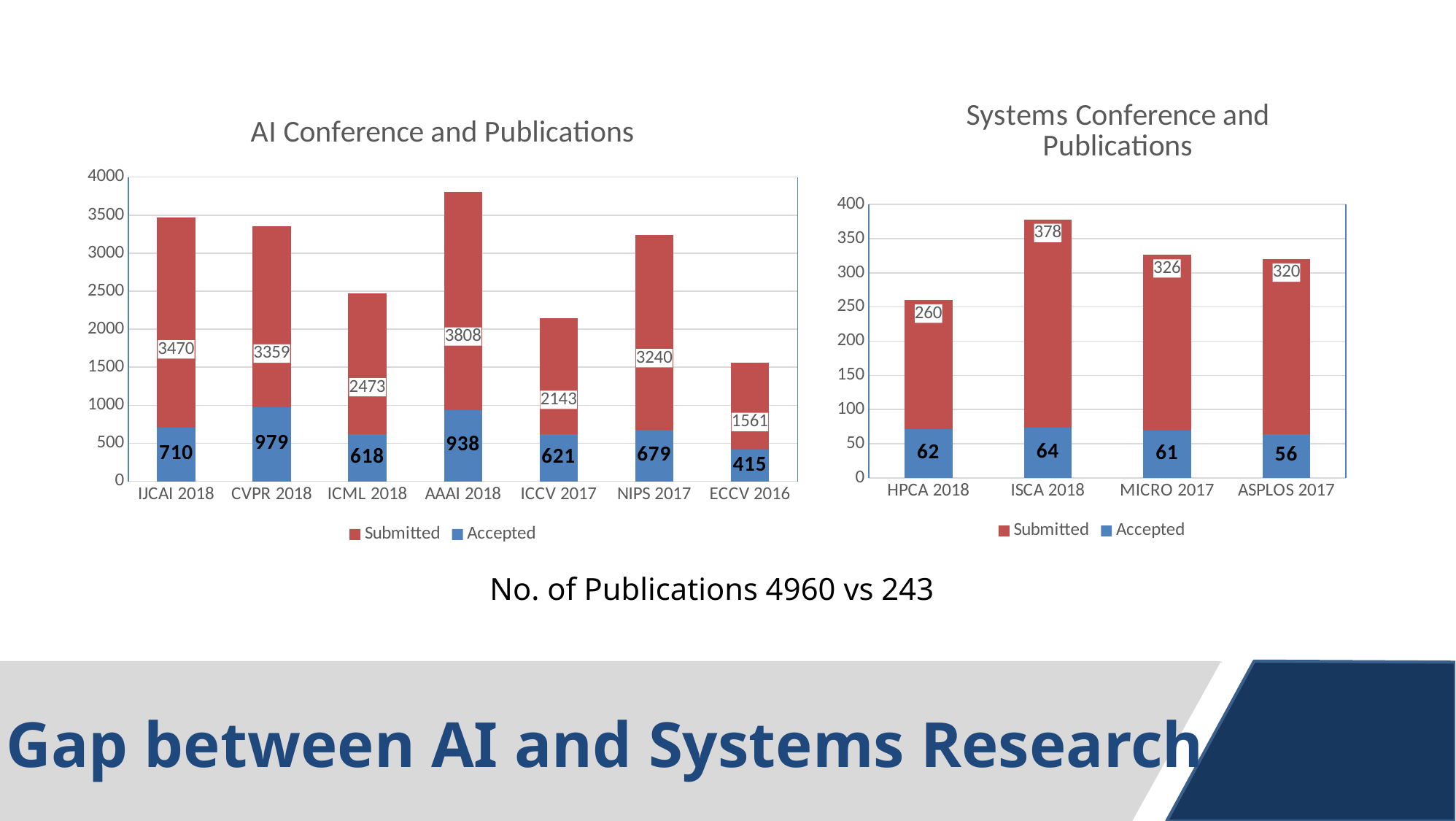
In the Systems Conference and Publications chart, which conference has the highest Submitted value? ISCA 2018 In the AI Conference and Publications chart, which conference has the lowest Accepted value? ECCV 2016 In the AI Conference and Publications chart, how many conferences are shown on the x axis? 7 What type of chart is the AI Conference and Publications chart? Stacked bar chart In the Systems Conference and Publications chart, what is the difference between the Submitted values for ISCA 2018 and HPCA 2018? 118 In the Systems Conference and Publications chart, what is the Submitted value for MICRO 2017? 326 In the Systems Conference and Publications chart, what is the Accepted value for ASPLOS 2017? 56 In the AI Conference and Publications chart, what is the Accepted value for CVPR 2018? 979 How many series does the legend of the Systems Conference and Publications chart list? 2 In the AI Conference and Publications chart, which is larger: the Accepted value for AAAI 2018 or for IJCAI 2018? AAAI 2018 In the AI Conference and Publications chart, which conference has the highest Submitted value? AAAI 2018 In the AI Conference and Publications chart, what is the Submitted value for IJCAI 2018? 3470